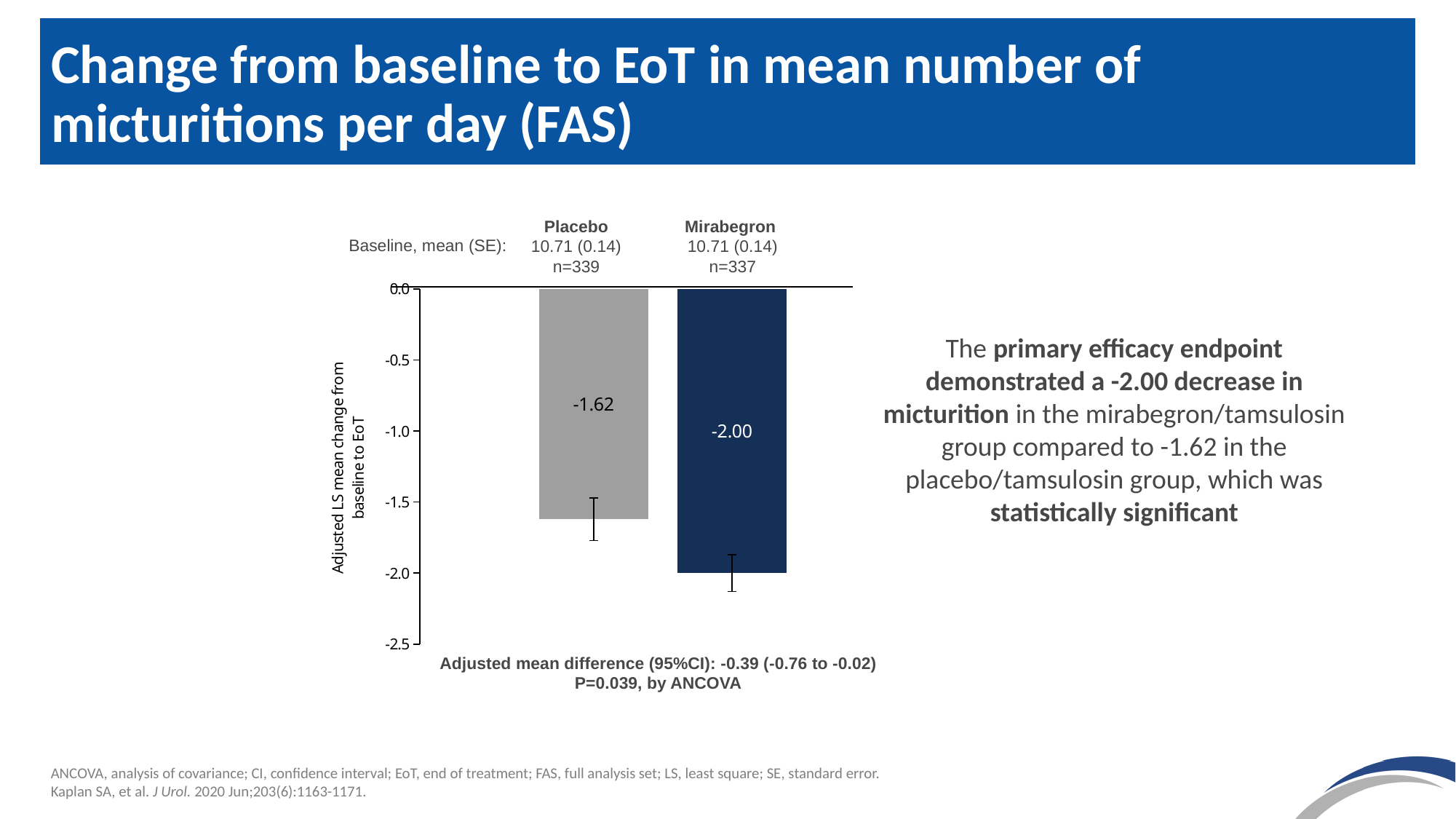
What kind of chart is shown on the slide? Bar chart What is the adjusted mean difference (95% CI) shown below the chart? -0.39 (-0.76 to -0.02) Which group has the lowest (most negative) adjusted LS mean change? Mirabegron How many groups are plotted in the chart? 2 Is the value for Placebo greater or less than -1.5? less How many patients (n) are in the Mirabegron group? n=337 Which group shows the larger decrease in mean number of micturitions per day? Mirabegron What is the label of the y axis? Adjusted LS mean change from baseline to EoT What is the adjusted LS mean change from baseline to EoT for the Mirabegron group? -2.00 What is the baseline mean (SE) for the Placebo group? 10.71 (0.14) What is the adjusted LS mean change from baseline to EoT for the Placebo group? -1.62 What is the difference between the Mirabegron and Placebo adjusted LS mean changes? 0.38